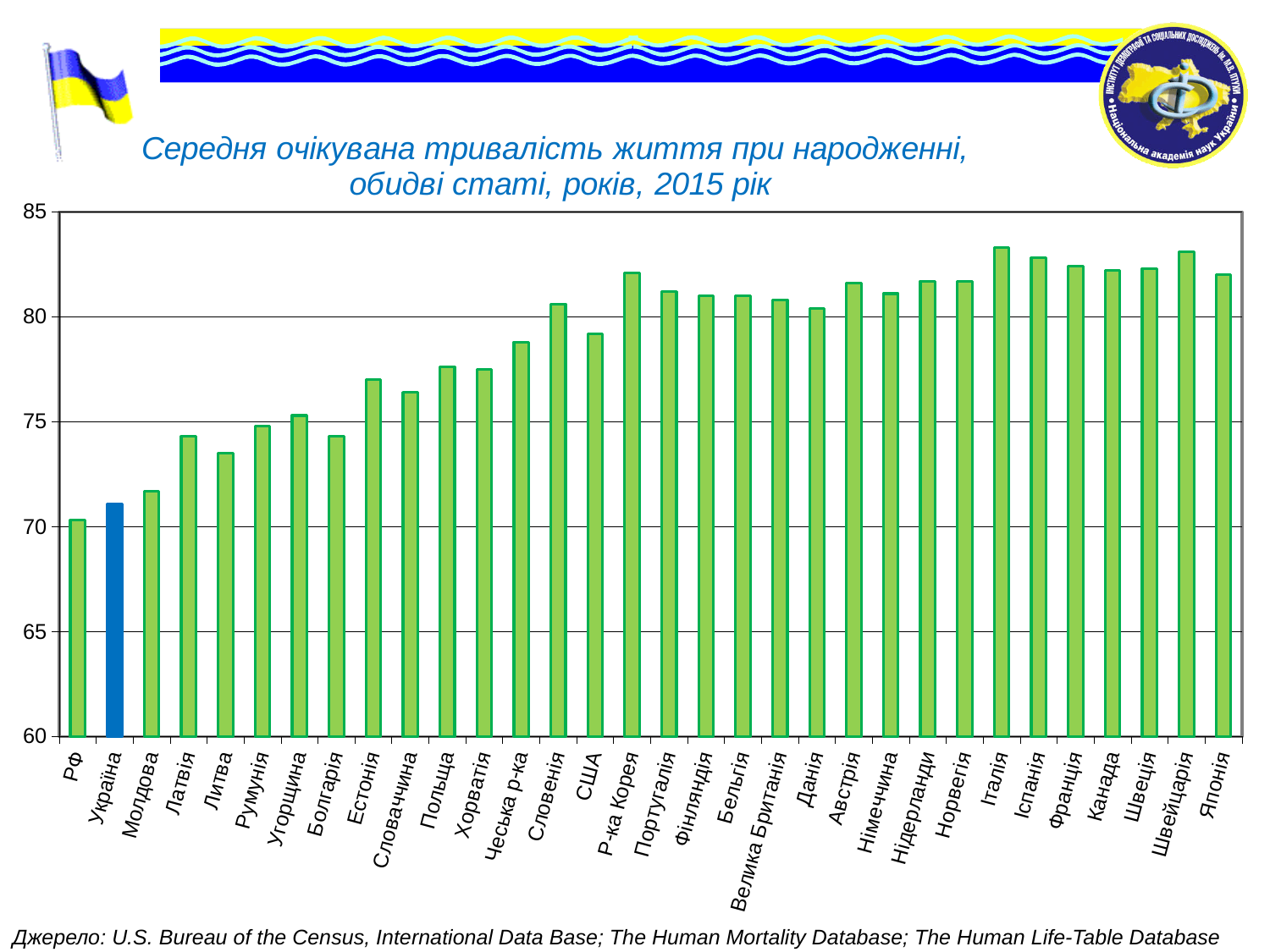
Is the value for Литва greater or less than 75? less Which country's bar is drawn in a different colour (blue) from the others? Україна Is the value for США greater or less than 80? less What kind of chart is shown on the slide? bar chart What year does the chart title say the data refer to? 2015 Which country has the lowest life expectancy in the chart? РФ Which has a higher value, Японія or РФ? Японія Which has a higher value, Польща or Латвія? Польща How many countries are shown on the x axis of the chart? 32 Is the value for Україна greater or less than 70? greater